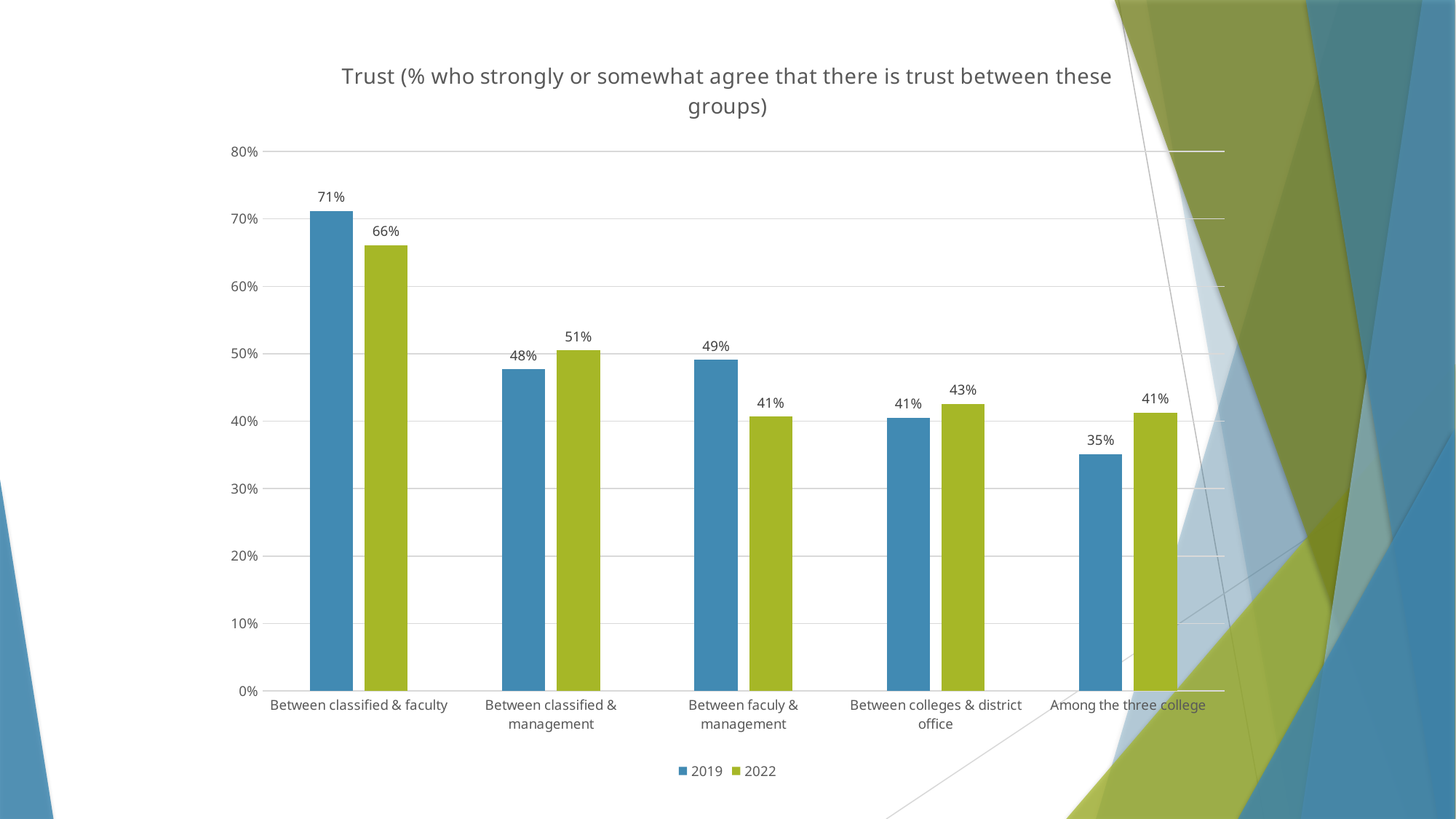
What is the difference between the 2019 and 2022 values for Between faculty & management? 8 percentage points Is the 2019 value for Among the three college greater or less than 40%? less Which is larger for Between colleges & district office, the 2019 value or the 2022 value? 2022 Which category has the lowest 2019 value? Among the three college What is the 2022 value for Between classified & management? 51% What are the two series named in the legend? 2019 and 2022 How many categories are shown on the x axis? 5 What is the 2019 value for Between classified & faculty? 71% What is the 2022 value for Among the three college? 41% What kind of chart is shown on the slide? bar chart Which category has the highest 2019 value? Between classified & faculty How many series does the legend list? 2